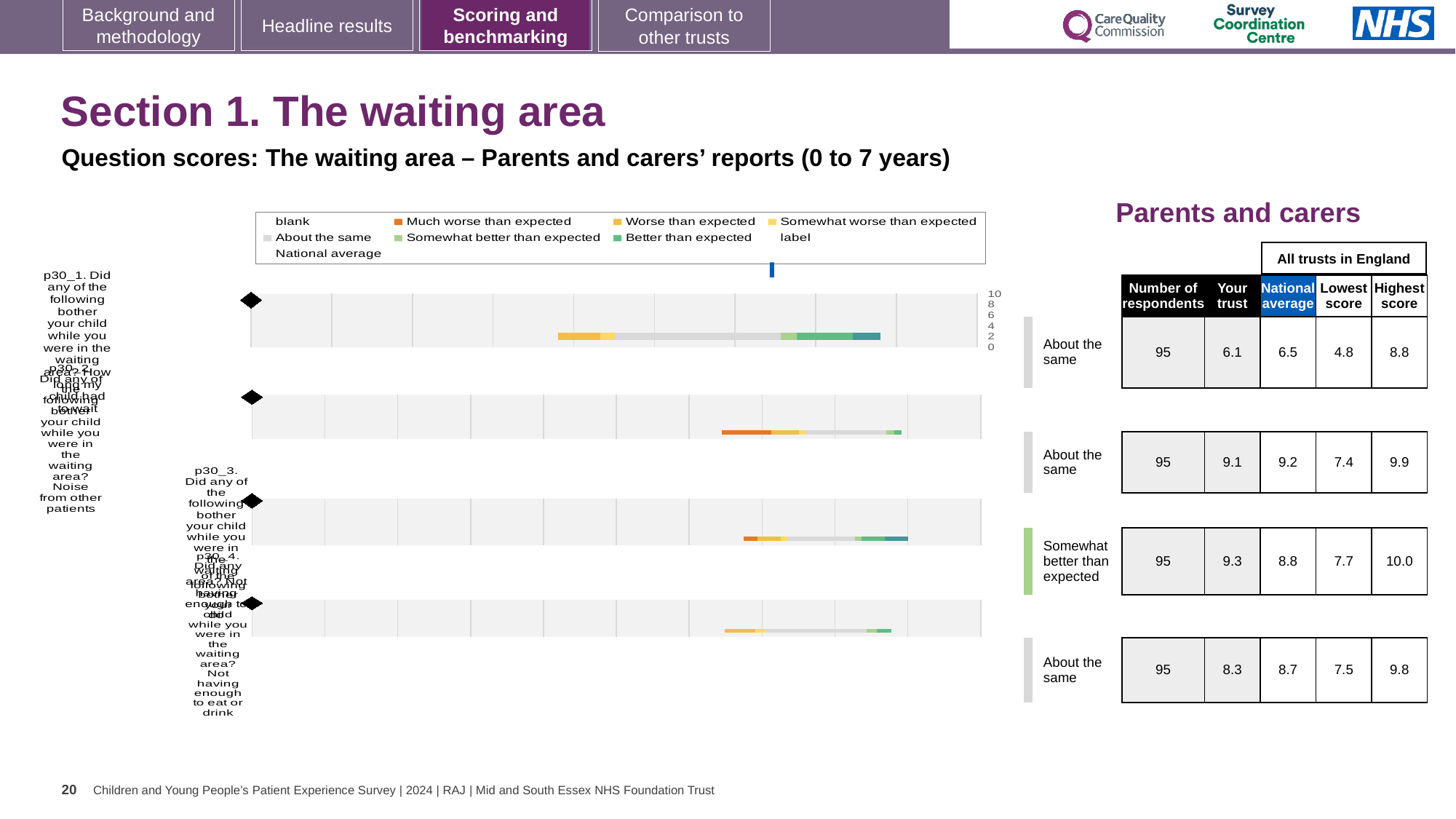
Which legend entry is shown in dark orange? Much worse than expected How many entries does the chart legend list? 9 Which question row has the lowest 'Your trust' score in the table? the first row (p30_1), 6.1 In the table beside the chart, what is the 'Your trust' score for the first question row (p30_1)? 6.1 What benchmark category is given for the third question row (p30_3)? Somewhat better than expected Which question row has the highest 'Your trust' score in the table? the third row (p30_3), 9.3 What is the difference between the 'Your trust' score and the national average for the third question row (p30_3)? 0.5 How many question bars are plotted in the chart? 4 What is the highest value shown on the chart's score axis? 10 In the table beside the chart, what is the national average for the second question row (p30_2)? 9.2 For the third question row (p30_3), is the 'Your trust' score or the national average larger? Your trust (9.3) What kind of chart is shown on the slide? bar chart